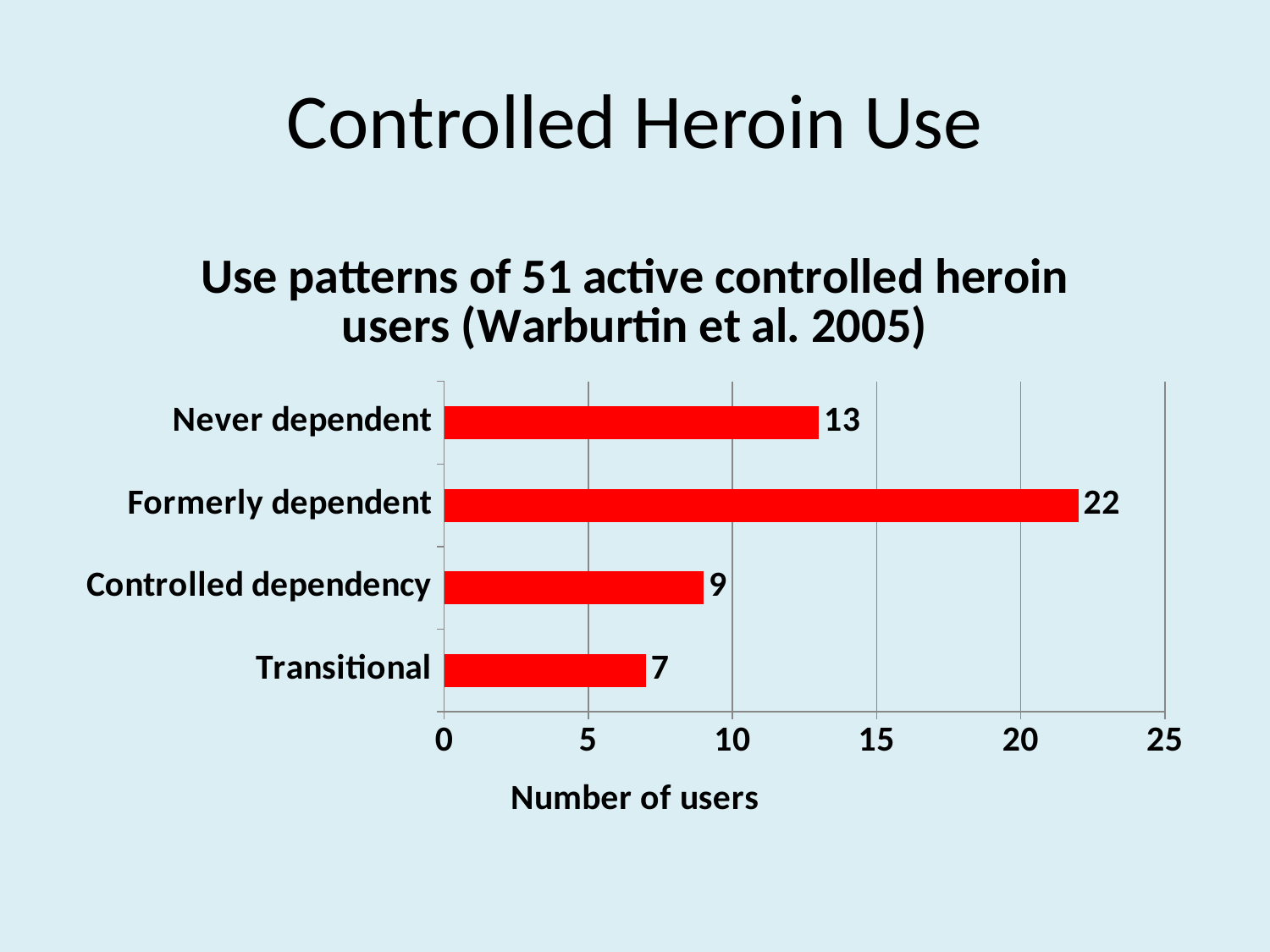
What is the number of users for Never dependent? 13 Is the value for Never dependent greater or less than 10? greater What is the number of users for Transitional? 7 What kind of chart is shown on the slide? Bar chart What is the difference in number of users between Formerly dependent and Never dependent? 9 Which category has the highest number of users? Formerly dependent Which has more users, Controlled dependency or Transitional? Controlled dependency What is the label of the horizontal axis? Number of users What is the number of users for Controlled dependency? 9 Which category has the lowest number of users? Transitional What is the number of users for Formerly dependent? 22 How many categories are shown in the chart? 4